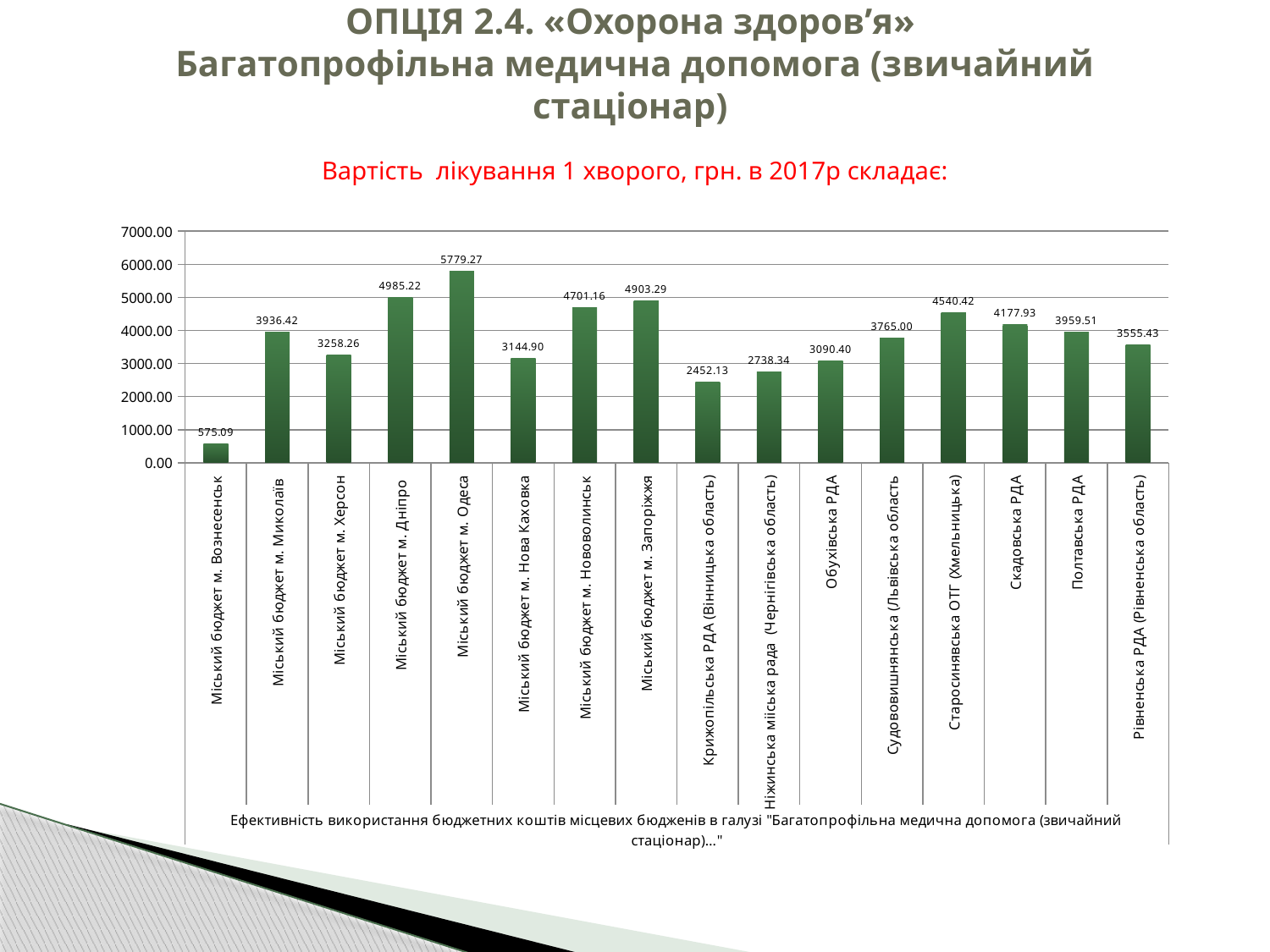
What is the value for Старосинявська ОТГ (Хмельницька)? 4540.42 What is the value for Ніжинська міська рада (Чернігівська область)? 2738.34 What is the value for Міський бюджет м. Одеса? 5779.27 How many categories are shown on the chart? 16 What is the difference between the values for Міський бюджет м. Дніпро and Міський бюджет м. Запоріжжя? 81.93 Which is larger, the value for Скадовська РДА or the value for Судововишнянська (Львівська область)? Скадовська РДА What year does the red subtitle above the chart say the treatment cost refers to? 2017 Which category has the highest value? Міський бюджет м. Одеса What kind of chart is shown on the slide? bar chart What is the difference between the values for Міський бюджет м. Одеса and Міський бюджет м. Вознесенськ? 5204.18 Which category has the lowest value? Міський бюджет м. Вознесенськ Is the value for Крижопільська РДА (Вінницька область) greater or less than 3000? less